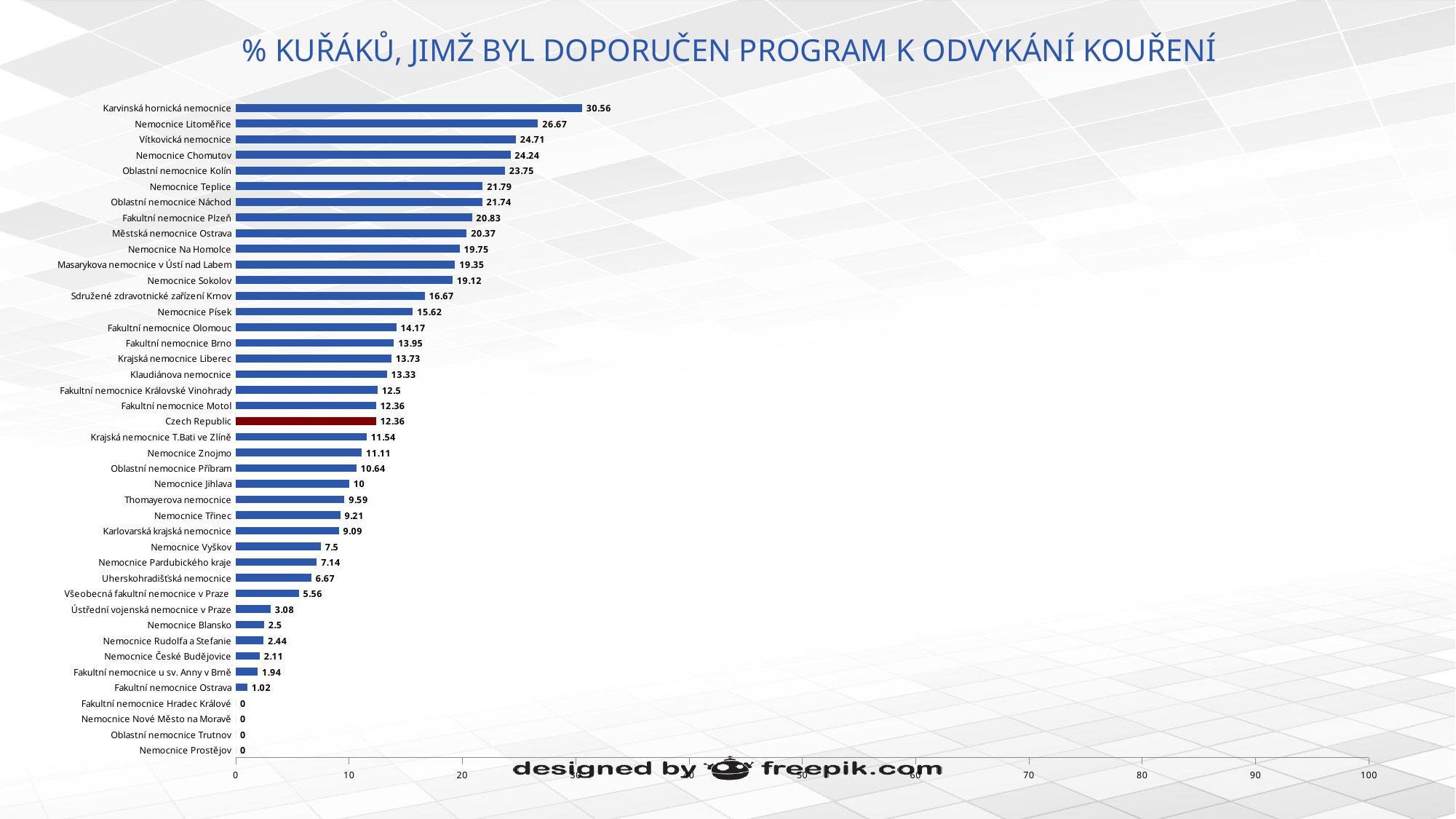
Which is larger, the value for Nemocnice Teplice or the value for Nemocnice Sokolov? Nemocnice Teplice What is the value for Fakultní nemocnice Ostrava? 1.02 Which category has the highest value? Karvinská hornická nemocnice What is the value for Czech Republic? 12.36 Is the value for Nemocnice Chomutov greater or less than 20? greater How many categories have a value of 0? 4 What is the difference between the values for Nemocnice Litoměřice and Vítkovická nemocnice? 1.96 What is the difference between the values for Karvinská hornická nemocnice and Czech Republic? 18.2 What is the value for Karvinská hornická nemocnice? 30.56 What kind of chart is shown on the slide? bar chart What is the value for Nemocnice Jihlava? 10 Which category's bar is shown in a different colour (dark red) from the others? Czech Republic